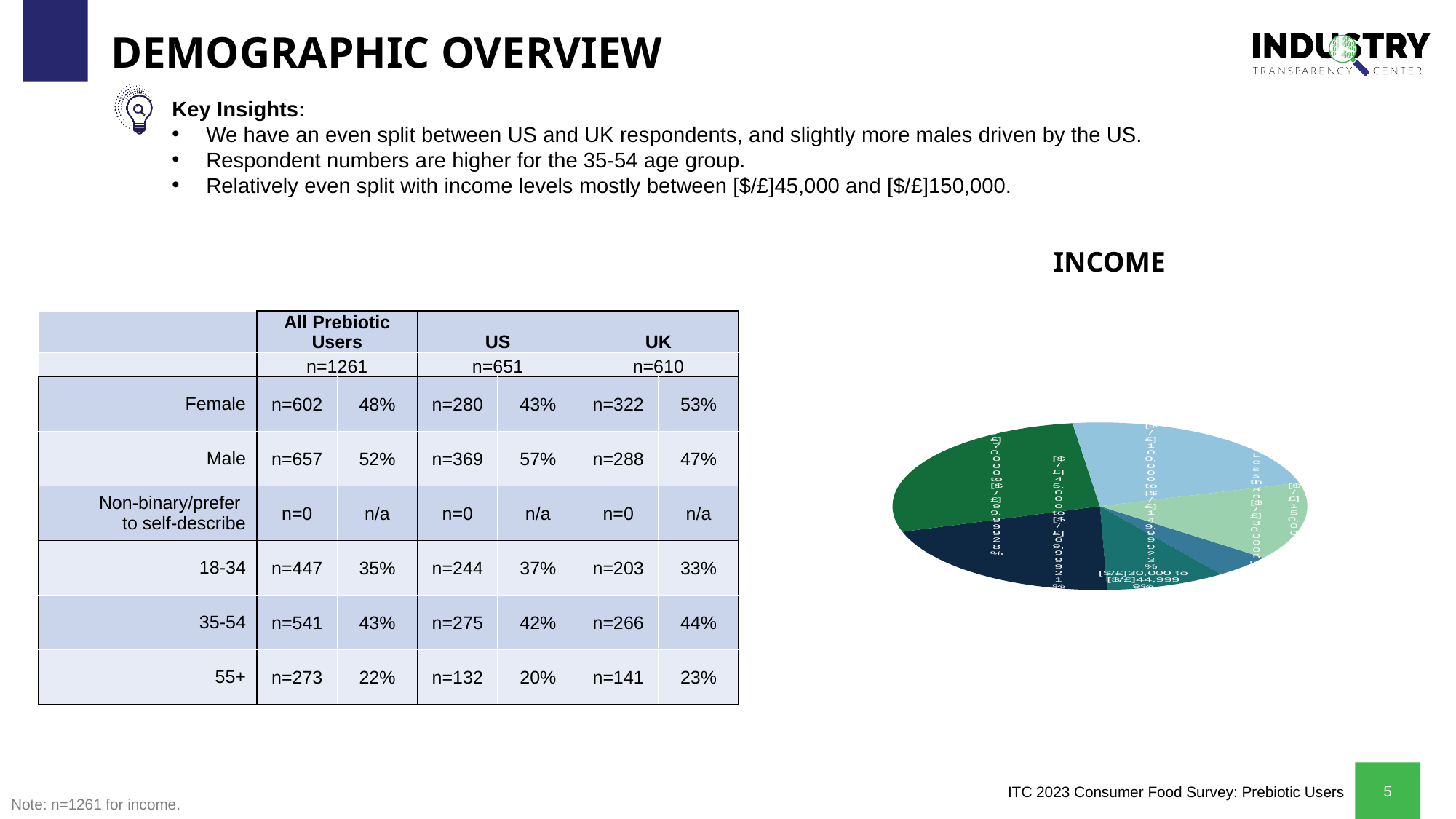
In the INCOME pie chart, what share of respondents have an income of [$/£]70,000 to [$/£]99,999? 28% In the INCOME pie chart, which slice is larger: [$/£]70,000 to [$/£]99,999 or [$/£]30,000 to [$/£]44,999? [$/£]70,000 to [$/£]99,999 In the INCOME pie chart, which income band has the smallest slice? Less than [$/£]30,000 In the INCOME pie chart, what is the difference in share between the [$/£]70,000 to [$/£]99,999 slice and the [$/£]30,000 to [$/£]44,999 slice? 19% How many slices does the INCOME pie chart have? 6 What is the title of the chart on the right side of the slide? INCOME What kind of chart is the INCOME chart on the slide? pie chart In the INCOME pie chart, what share of respondents have an income of [$/£]30,000 to [$/£]44,999? 9% In the INCOME pie chart, what share of respondents have an income of [$/£]45,000 to [$/£]69,999? 21%